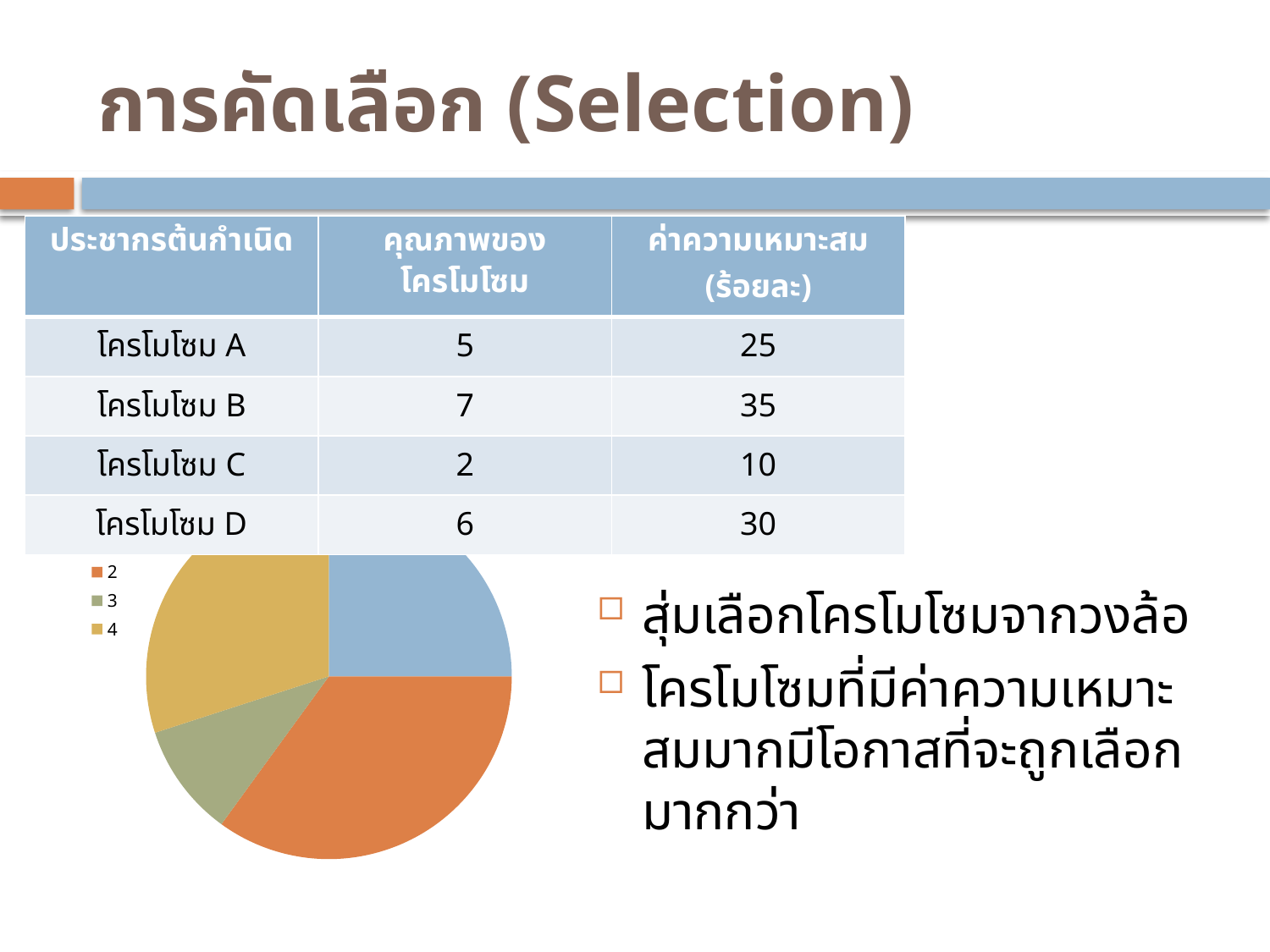
How many entries are listed in the pie chart's legend? 3 Which legend entry corresponds to the smallest slice of the pie chart? 3 How many slices does the pie chart have? 4 What colour is the slice for legend entry 4 in the pie chart? yellow What colour is the slice for legend entry 2 in the pie chart? orange In the pie chart, which slice is larger, the one for legend entry 2 or the one for legend entry 3? 2 Which legend entry corresponds to the largest slice of the pie chart? 2 In the pie chart, which slice is larger, the one for legend entry 4 or the one for legend entry 3? 4 What kind of chart is shown on the slide? pie chart